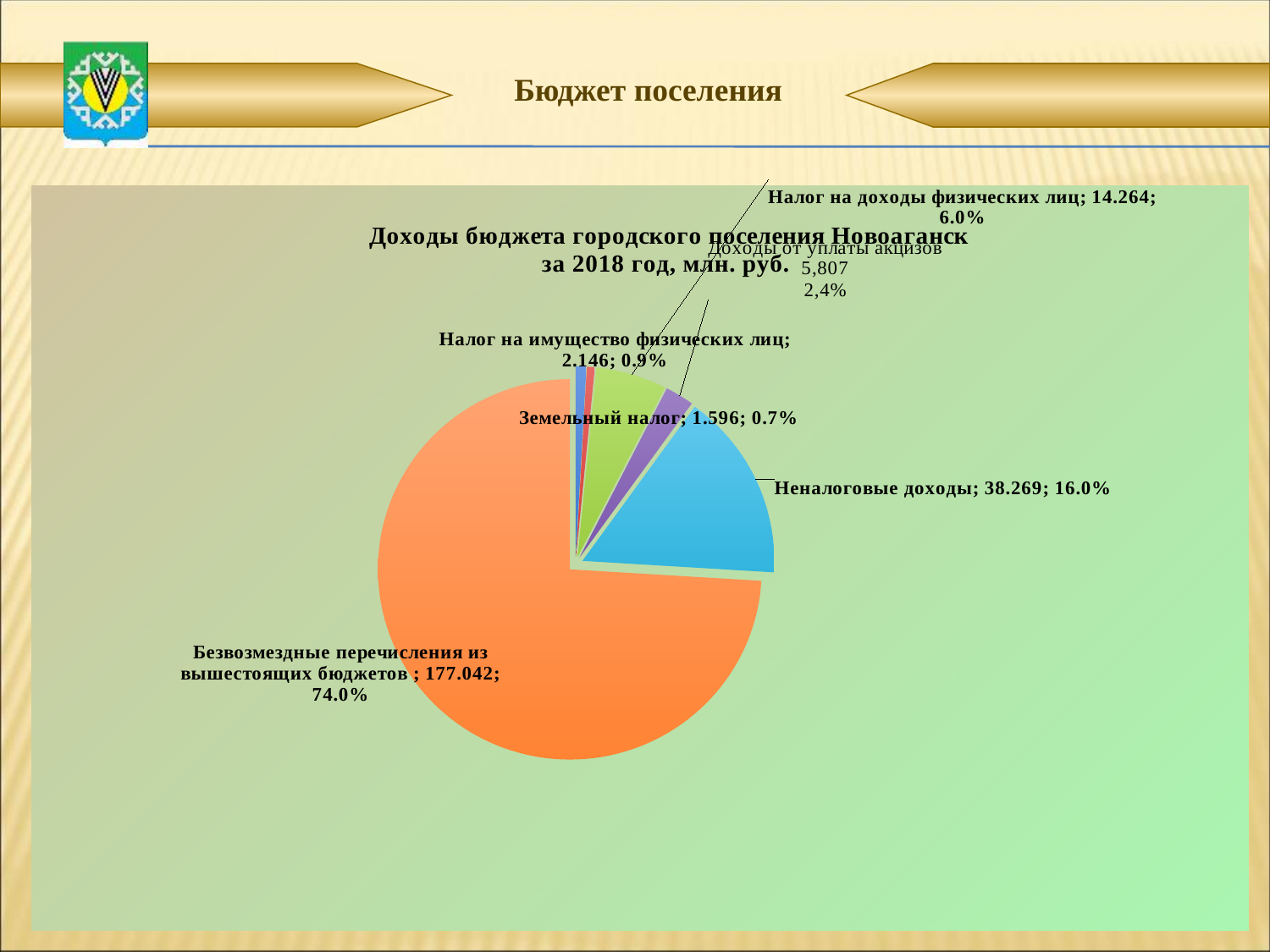
What kind of chart is shown on the slide? pie chart What share of the pie does Неналоговые доходы take? 16.0% How many slices does the pie chart have? 6 Which is larger, Налог на доходы физических лиц or Налог на имущество физических лиц? Налог на доходы физических лиц What is the difference between the values for Неналоговые доходы and Налог на доходы физических лиц? 24.005 What is the value for Налог на доходы физических лиц? 14.264 What is the value for Неналоговые доходы? 38.269 What share of the pie does Доходы от уплаты акцизов take? 2,4% What is the value for Земельный налог? 1.596 Which category has the largest slice of the pie? Безвозмездные перечисления из вышестоящих бюджетов What is the value for Безвозмездные перечисления из вышестоящих бюджетов? 177.042 Which category has the smallest slice of the pie? Земельный налог